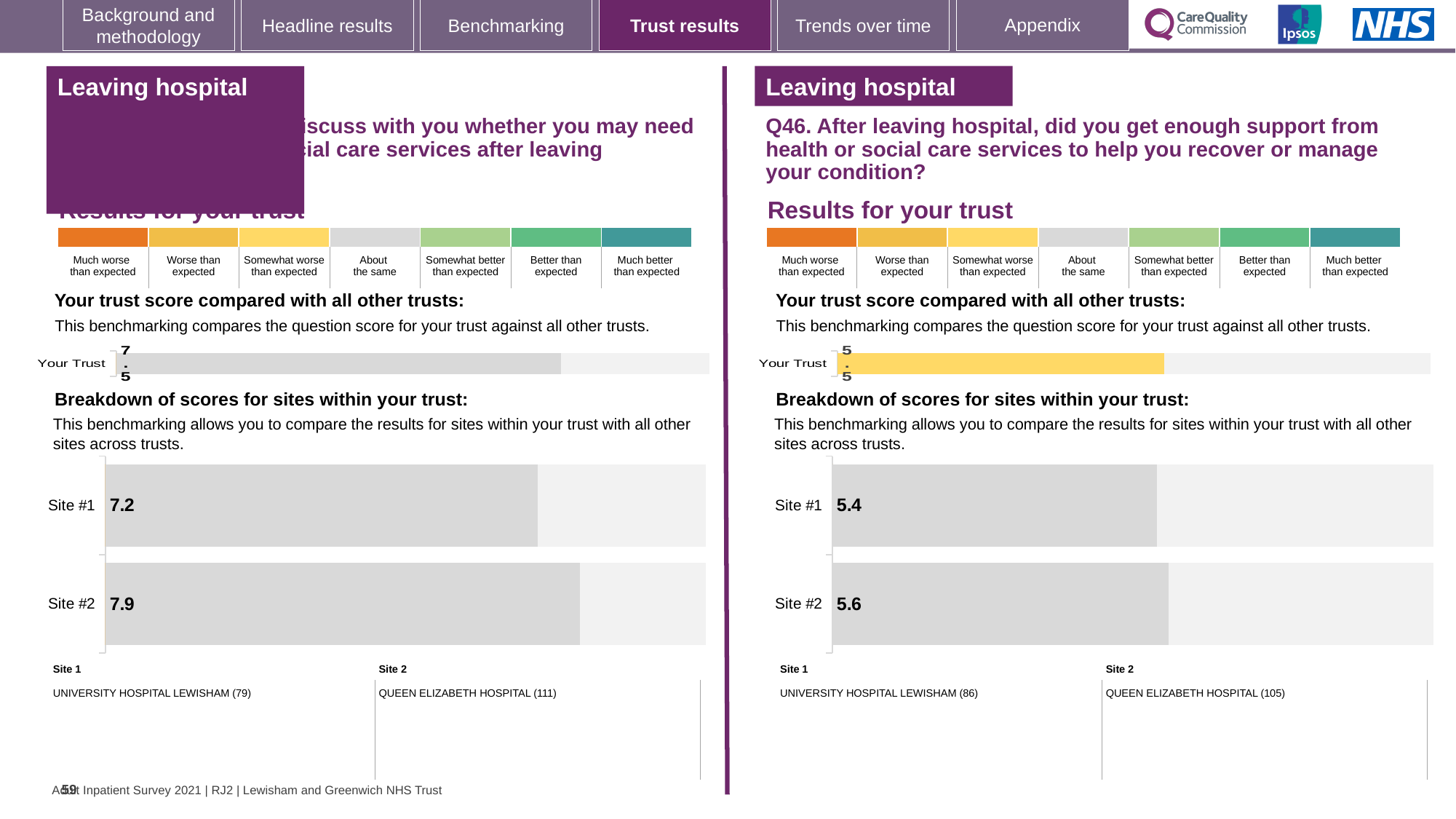
On the left-hand 'Your Trust' chart, what is the trust score shown? 7.5 On the right-hand (Q46) site breakdown chart, what is the difference between the Site #2 and Site #1 scores? 0.2 What type of chart is used for the site breakdown on the left-hand side of the slide? Bar chart On the left-hand site breakdown chart, what is the score for Site #1? 7.2 On the right-hand (Q46) site breakdown chart, what is the score for Site #2? 5.6 On the right-hand (Q46) site breakdown chart, which site has the lower score? Site #1 On the left-hand site breakdown chart, which site has the higher score? Site #2 On the left-hand site breakdown chart, what is the score for Site #2? 7.9 On the right-hand (Q46) site breakdown chart, what is the score for Site #1? 5.4 How many sites are shown on the right-hand (Q46) site breakdown chart? 2 On the left-hand site breakdown chart, what is the difference between the Site #2 and Site #1 scores? 0.7 On the right-hand (Q46) 'Your Trust' chart, what is the trust score shown? 5.5